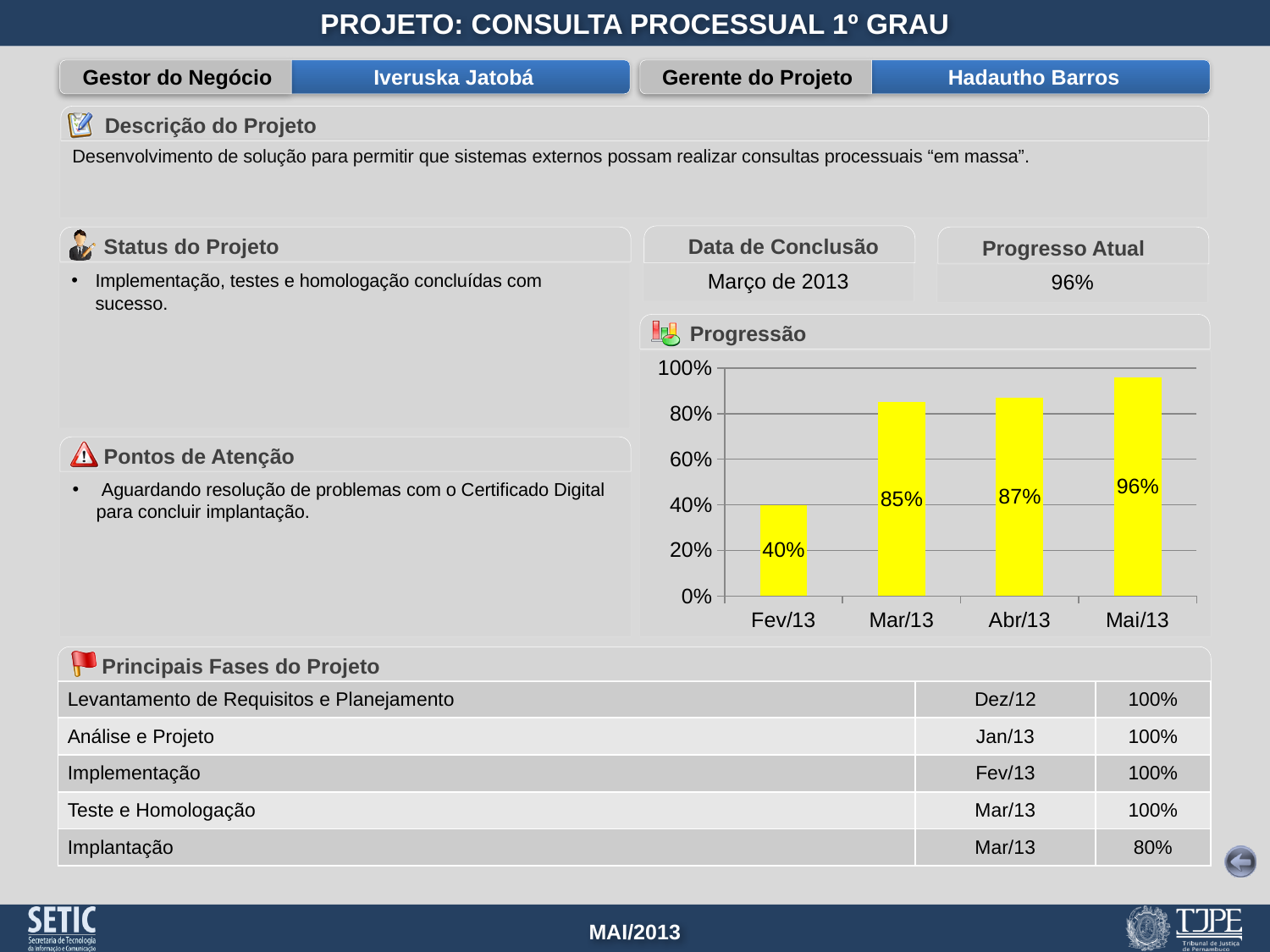
Which is larger in the Progressão chart, the value for Mar/13 or the value for Fev/13? Mar/13 How many months are shown on the x axis of the Progressão chart? 4 What is the difference between the values for Mai/13 and Fev/13 in the Progressão chart? 56% What is the value for Mai/13 in the Progressão chart? 96% What is the value for Mar/13 in the Progressão chart? 85% What is the value for Abr/13 in the Progressão chart? 87% Which month has the highest value in the Progressão chart? Mai/13 Which month has the lowest value in the Progressão chart? Fev/13 What is the difference between the values for Abr/13 and Mar/13 in the Progressão chart? 2% Do the values in the Progressão chart rise or fall from Fev/13 to Mai/13? rise What is the value for Fev/13 in the Progressão chart? 40% What kind of chart is the Progressão chart? bar chart